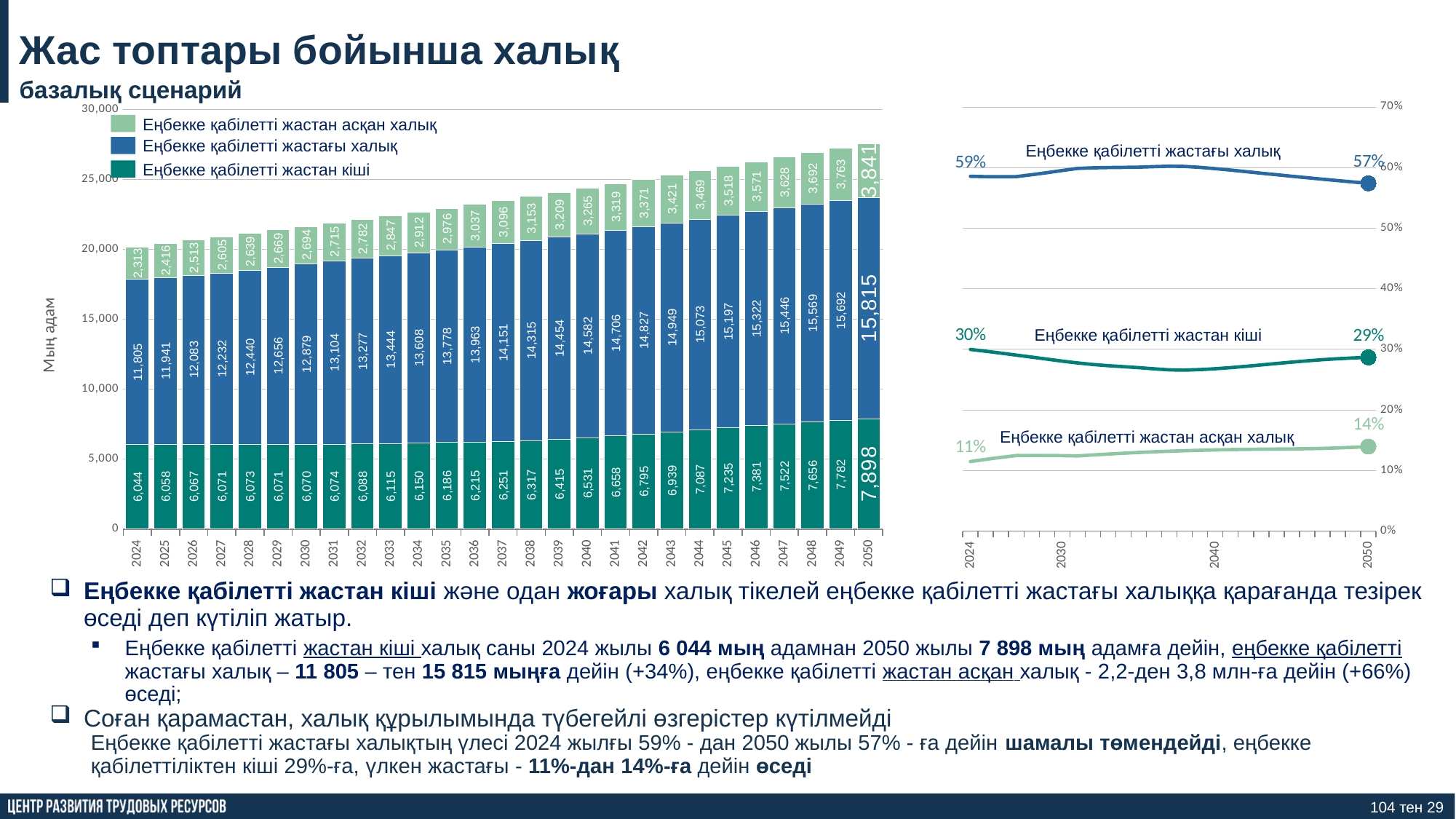
In the left bar chart, what is the value for Еңбекке қабілетті жастан кіші in 2050? 7,898 In the right line chart, what is the value for Еңбекке қабілетті жастан асқан халық in 2024? 11% What kind of chart is the left chart? Stacked bar chart In the left bar chart, what is the total of the stacked bar for 2024? 20,162 In the right line chart, what is the value for Еңбекке қабілетті жастағы халық in 2050? 57% In the right line chart, which series has the highest values? Еңбекке қабілетті жастағы халық In the left bar chart, how many years are shown on the x axis? 27 In the left bar chart, how many series does the legend list? 3 In the left bar chart, what is the value for Еңбекке қабілетті жастан асқан халық in 2050? 3,841 In the left bar chart, what is the value for Еңбекке қабілетті жастағы халық in 2024? 11,805 In the left bar chart, what is the difference between the Еңбекке қабілетті жастағы халық values for 2050 and 2024? 4,010 In the left bar chart, does the value for Еңбекке қабілетті жастағы халық rise or fall from 2024 to 2050? Rise